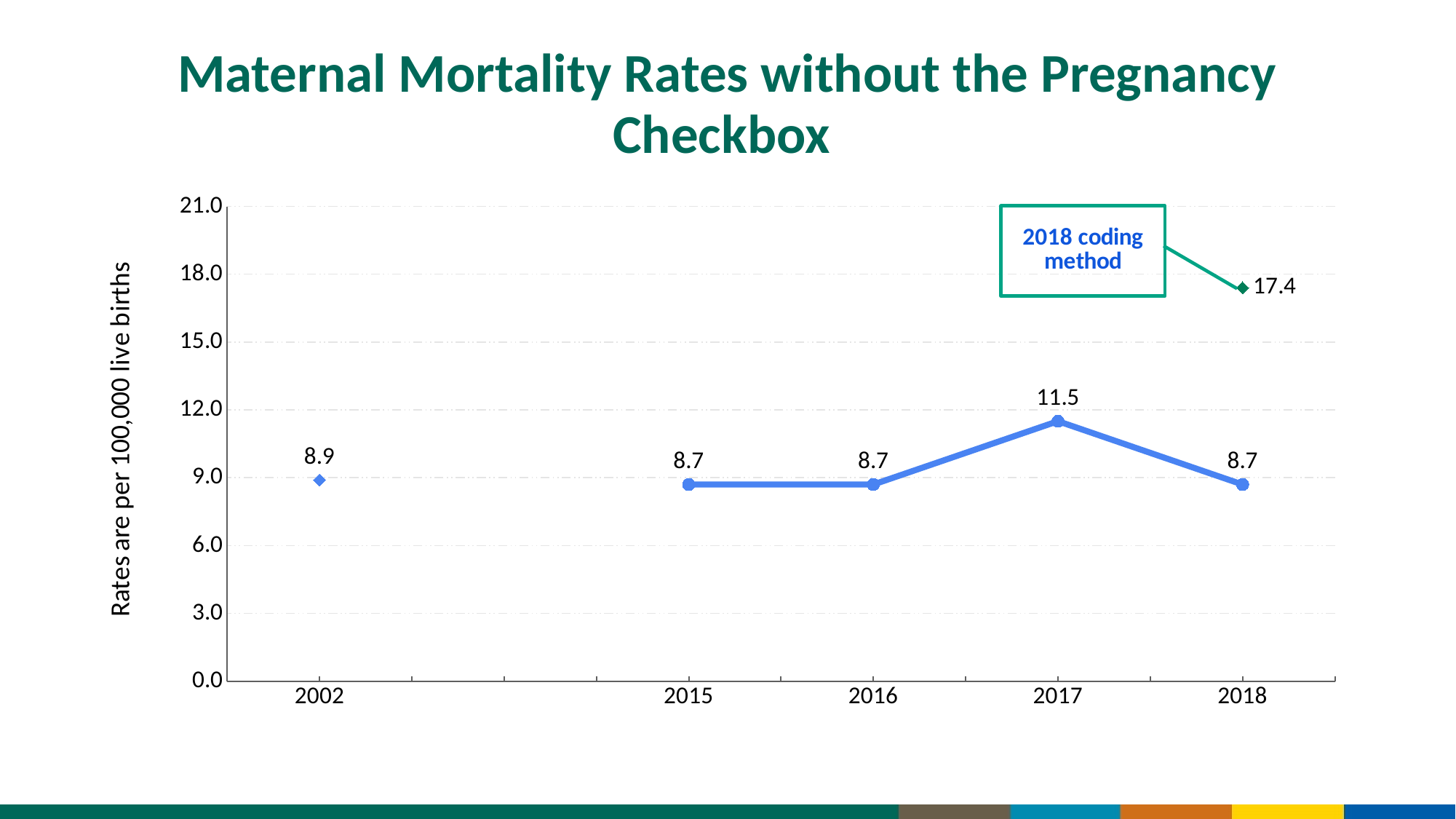
Which is larger, the value for 2002 or the value for 2015? 2002 What value is labelled for the 2018 coding method point? 17.4 What kind of chart is this? line chart Which year on the blue line has the highest value? 2017 How many years are labelled on the x axis? 5 Is the 2018 coding method value greater or less than 15.0? greater What is the difference between the 2018 coding method value and the 2018 value on the blue line? 8.7 What is the y-axis label of the chart? Rates are per 100,000 live births What is the difference between the 2017 value and the 2016 value? 2.8 What is the maternal mortality rate shown for 2002? 8.9 What is the maternal mortality rate shown for 2017? 11.5 What is the value for 2016? 8.7